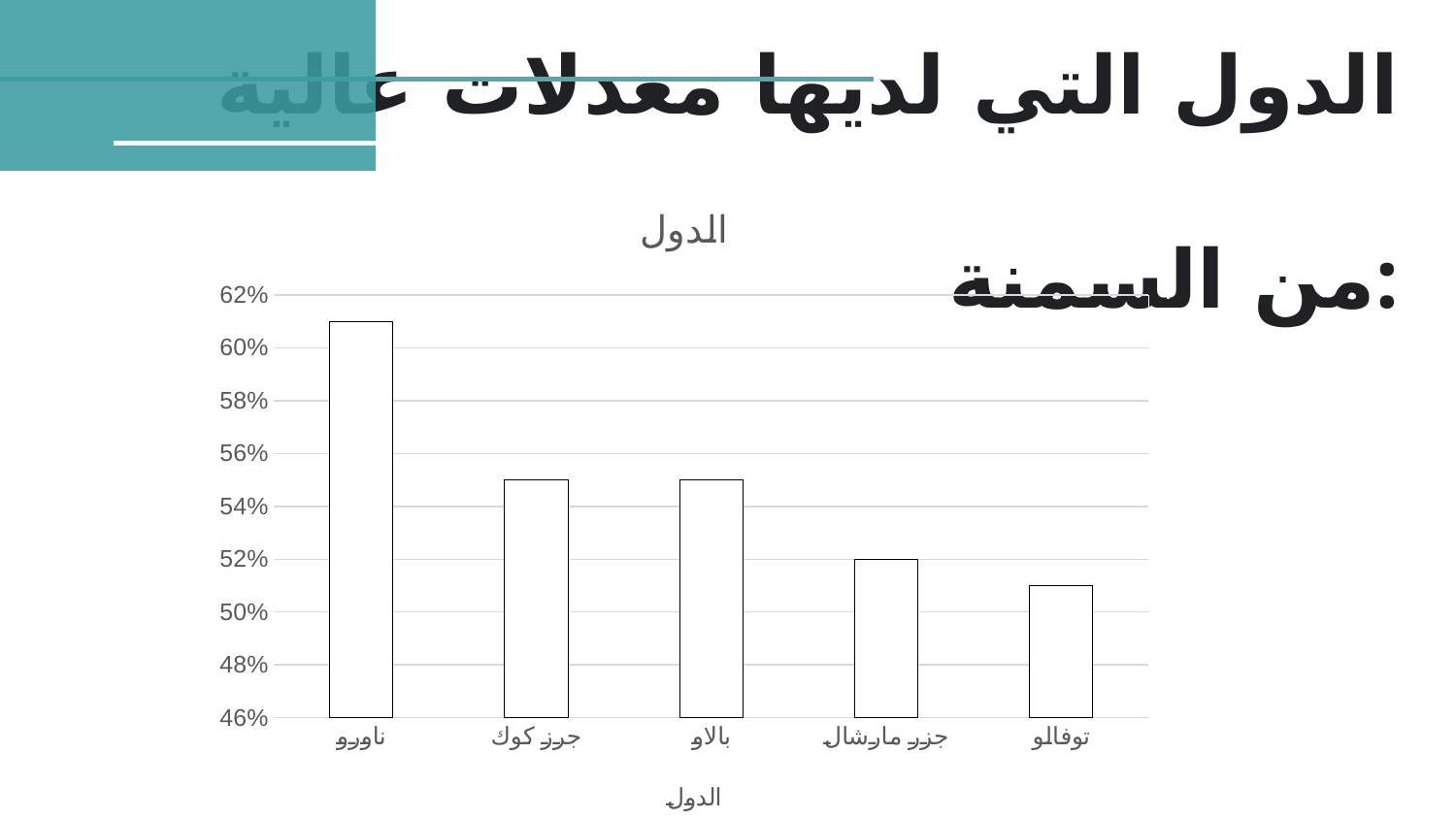
Which country has the highest bar in the chart? ناورو Is the value for بالاو greater or less than 54%? greater Is the value for ناورو greater or less than 60%? greater Which has a larger value, ناورو or جزر مارشال? ناورو Which country has the lowest bar in the chart? توفالو What kind of chart is shown on the slide? bar chart What is the value for جزر مارشال in the chart? 52% What is the title of the chart? الدول Do the values rise or fall from left to right along the x axis? fall How many countries are shown on the x axis of the chart? 5 Is the value for توفالو greater or less than 50%? greater